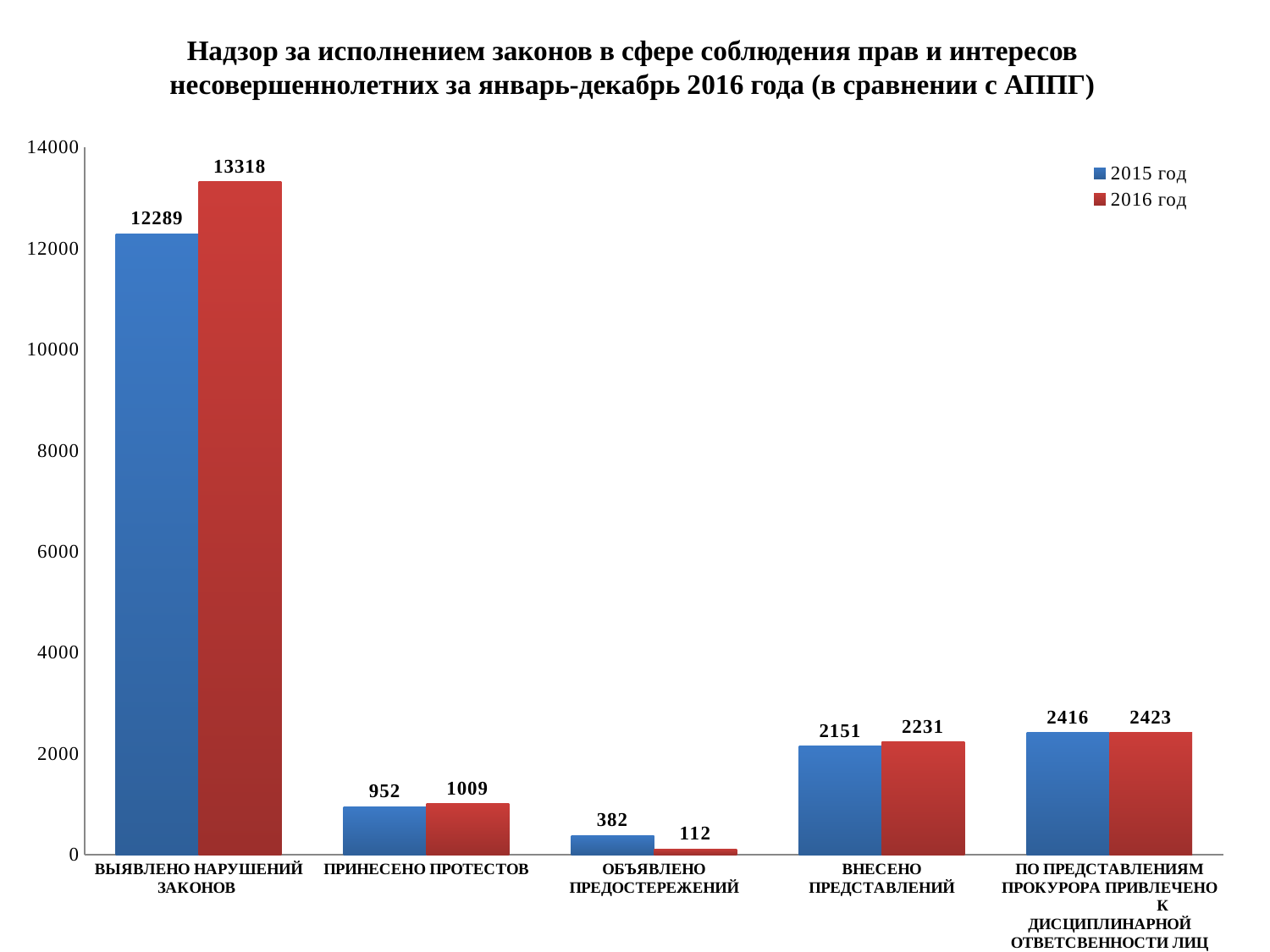
Which is larger for ВНЕСЕНО ПРЕДСТАВЛЕНИЙ: the 2015 год value or the 2016 год value? 2016 год Which category has the lowest value for 2016 год? ОБЪЯВЛЕНО ПРЕДОСТЕРЕЖЕНИЙ How many series does the legend list? 2 How many categories are shown on the x axis? 5 Is the 2015 год value for ВНЕСЕНО ПРЕДСТАВЛЕНИЙ greater or less than 2000? greater What is the value for 2016 год in the category ПРИНЕСЕНО ПРОТЕСТОВ? 1009 Which category has the highest value for 2015 год? ВЫЯВЛЕНО НАРУШЕНИЙ ЗАКОНОВ What is the difference between the 2016 год and 2015 год values for ВЫЯВЛЕНО НАРУШЕНИЙ ЗАКОНОВ? 1029 What is the value for 2015 год in the category ОБЪЯВЛЕНО ПРЕДОСТЕРЕЖЕНИЙ? 382 What is the difference between the 2015 год and 2016 год values for ОБЪЯВЛЕНО ПРЕДОСТЕРЕЖЕНИЙ? 270 What is the value for 2016 год in the category ВЫЯВЛЕНО НАРУШЕНИЙ ЗАКОНОВ? 13318 What kind of chart is shown on the slide? bar chart